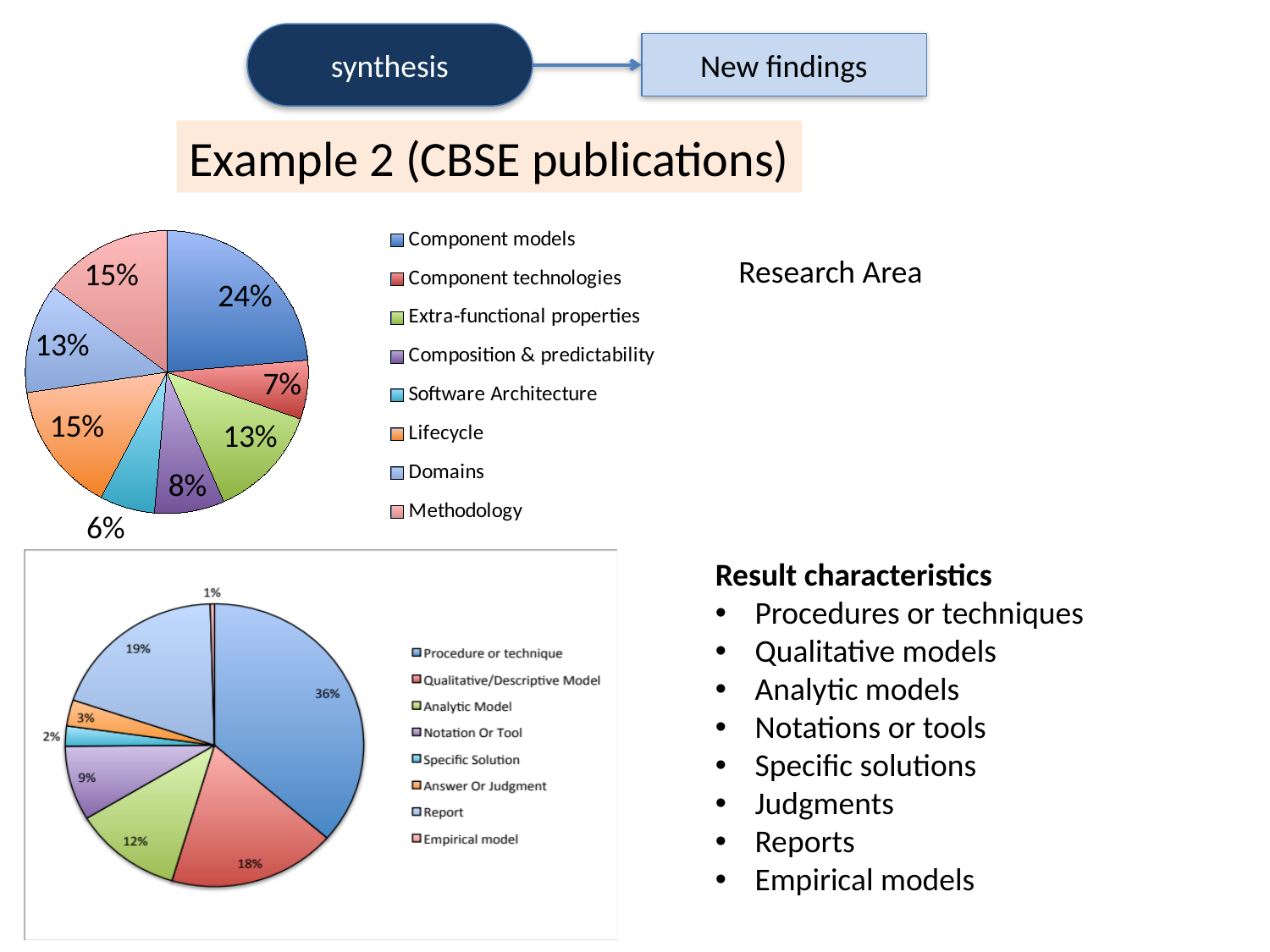
In the top pie chart (Research Area), what share is Software Architecture? 6% In the bottom pie chart (Result characteristics), which category has the smallest share? Empirical model In the bottom pie chart (Result characteristics), what share is Procedure or technique? 36% In the bottom pie chart (Result characteristics), what share is Report? 19% In the top pie chart (Research Area), which research area has the largest share? Component models What type of chart is the bottom chart on the slide? Pie chart In the top pie chart (Research Area), what is the difference between the shares of Component models and Component technologies? 17% In the top pie chart (Research Area), which is larger, Lifecycle or Composition & predictability? Lifecycle In the top pie chart (Research Area), which research area has the smallest share? Software Architecture How many categories does the legend of the top pie chart (Research Area) list? 8 In the top pie chart (Research Area), what share is Component models? 24% In the bottom pie chart (Result characteristics), what is the difference between the shares of Qualitative/Descriptive Model and Analytic Model? 6%